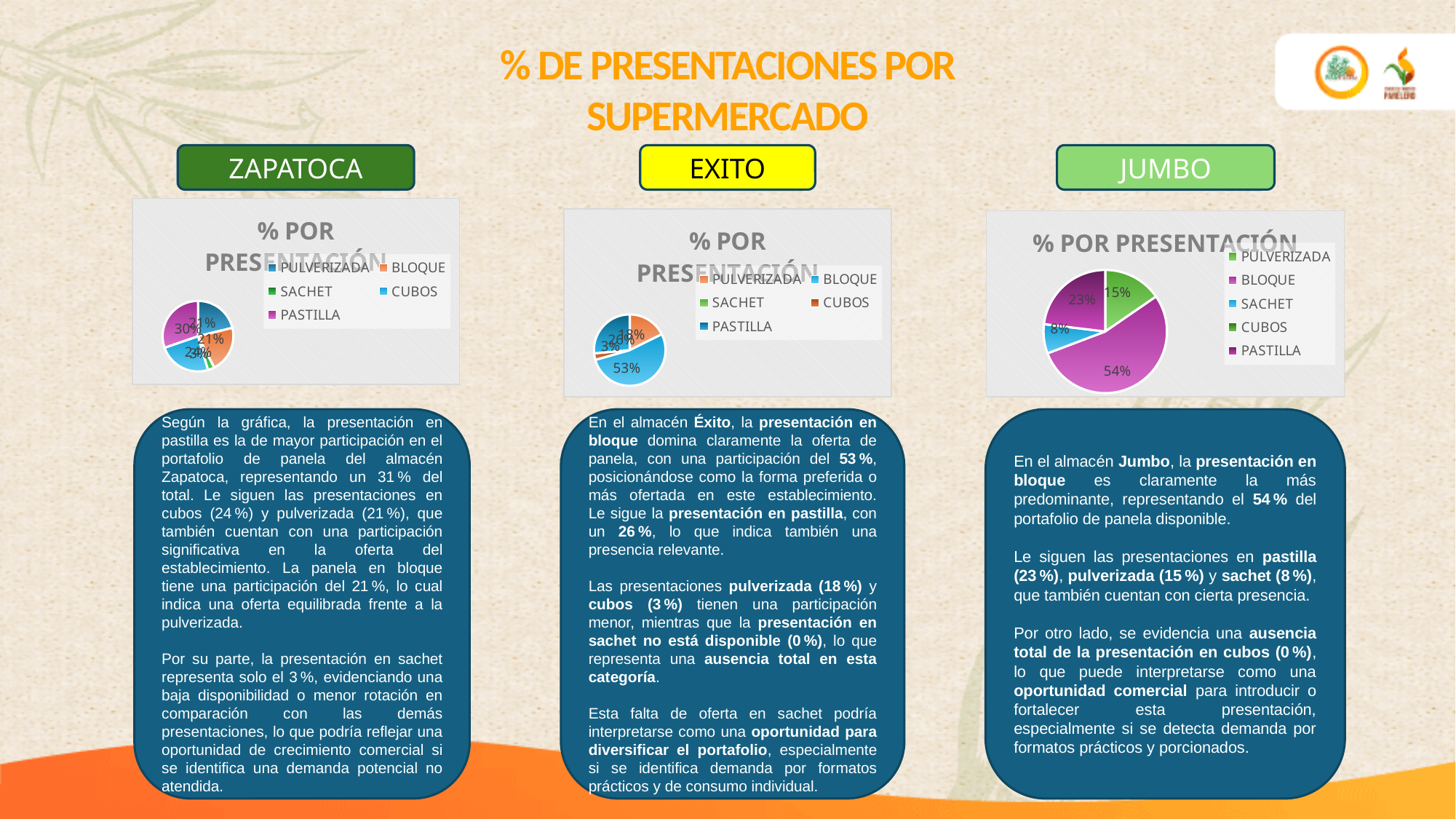
In the EXITO pie chart, what percentage is shown for PULVERIZADA? 18% In the JUMBO pie chart, what percentage is shown for SACHET? 8% In the EXITO pie chart, which is larger, BLOQUE or PASTILLA? BLOQUE In the EXITO pie chart, what is the largest percentage label shown? 53% How many entries does the legend of the JUMBO chart list? 5 In the JUMBO pie chart, what is the difference between the BLOQUE share and the PASTILLA share? 31 percentage points In the JUMBO pie chart, which presentation has the largest share? BLOQUE In the JUMBO pie chart, which is larger, PULVERIZADA or SACHET? PULVERIZADA In the JUMBO pie chart, what percentage is shown for BLOQUE? 54% What type of chart is used for the ZAPATOCA supermarket? Pie chart In the EXITO pie chart, what is the smallest percentage label shown? 3% In the JUMBO pie chart, what percentage is shown for PASTILLA? 23%